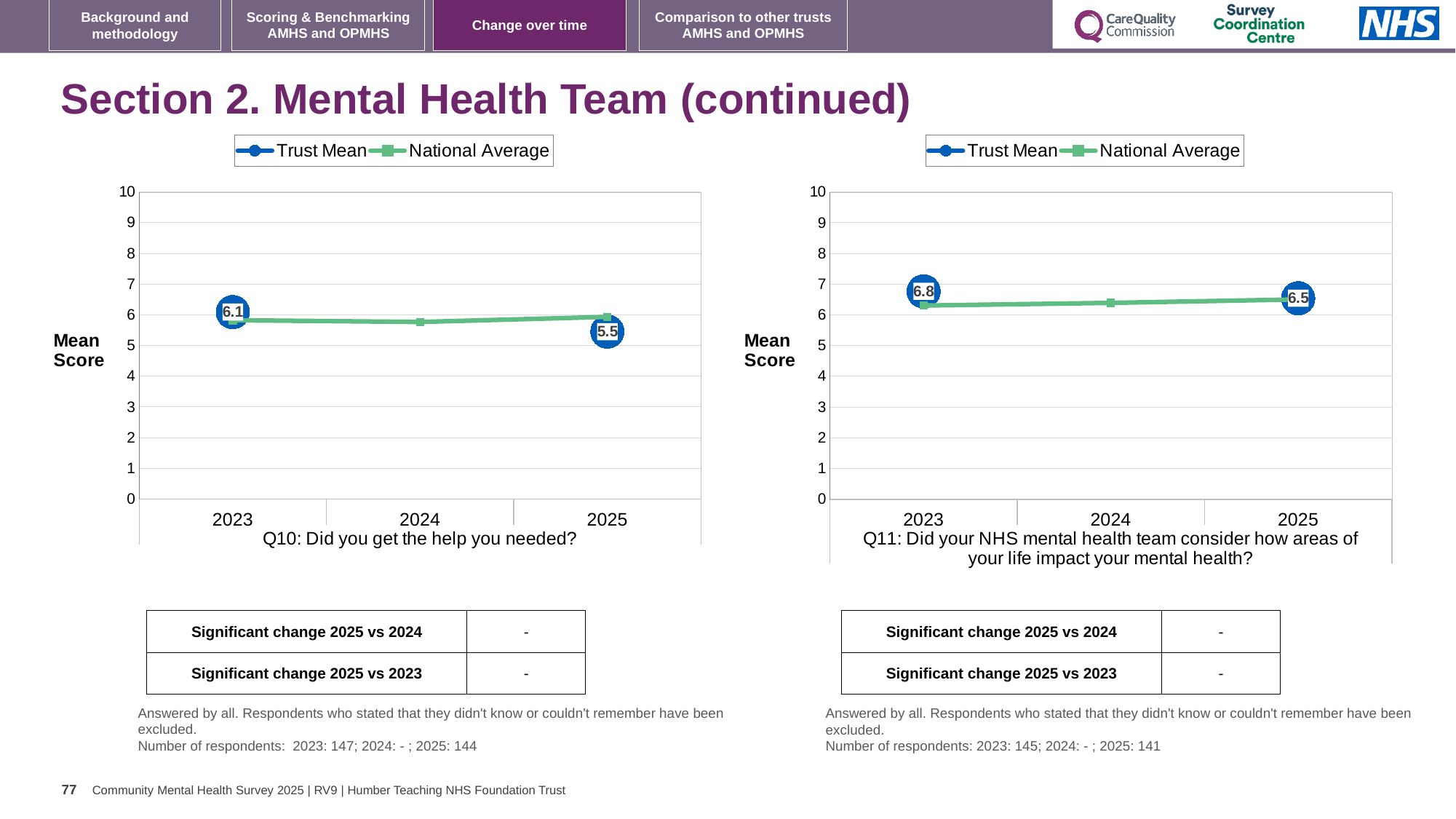
What type of chart is the Q10 chart on the left? line chart In the Q11 chart (right), what is the Trust Mean for 2023? 6.8 In the Q11 chart (right), is the National Average for 2023 greater or less than 7? less In the Q10 chart (left), what is the Trust Mean for 2025? 5.5 In the Q11 chart (right), what is the Trust Mean for 2025? 6.5 How many series does the legend of the Q11 chart (right) list? 2 In the Q10 chart (left), does the Trust Mean rise or fall from 2023 to 2025? fall In the Q11 chart (right), what is the difference between the Trust Mean in 2023 and in 2025? 0.3 How many years are shown on the x axis of the Q10 chart (left)? 3 Which is larger: the 2023 Trust Mean in the Q10 chart or the 2023 Trust Mean in the Q11 chart? Q11 chart (6.8) In the Q10 chart (left), by how much did the Trust Mean fall from 2023 to 2025? 0.6 In the Q10 chart (left), what is the Trust Mean for 2023? 6.1